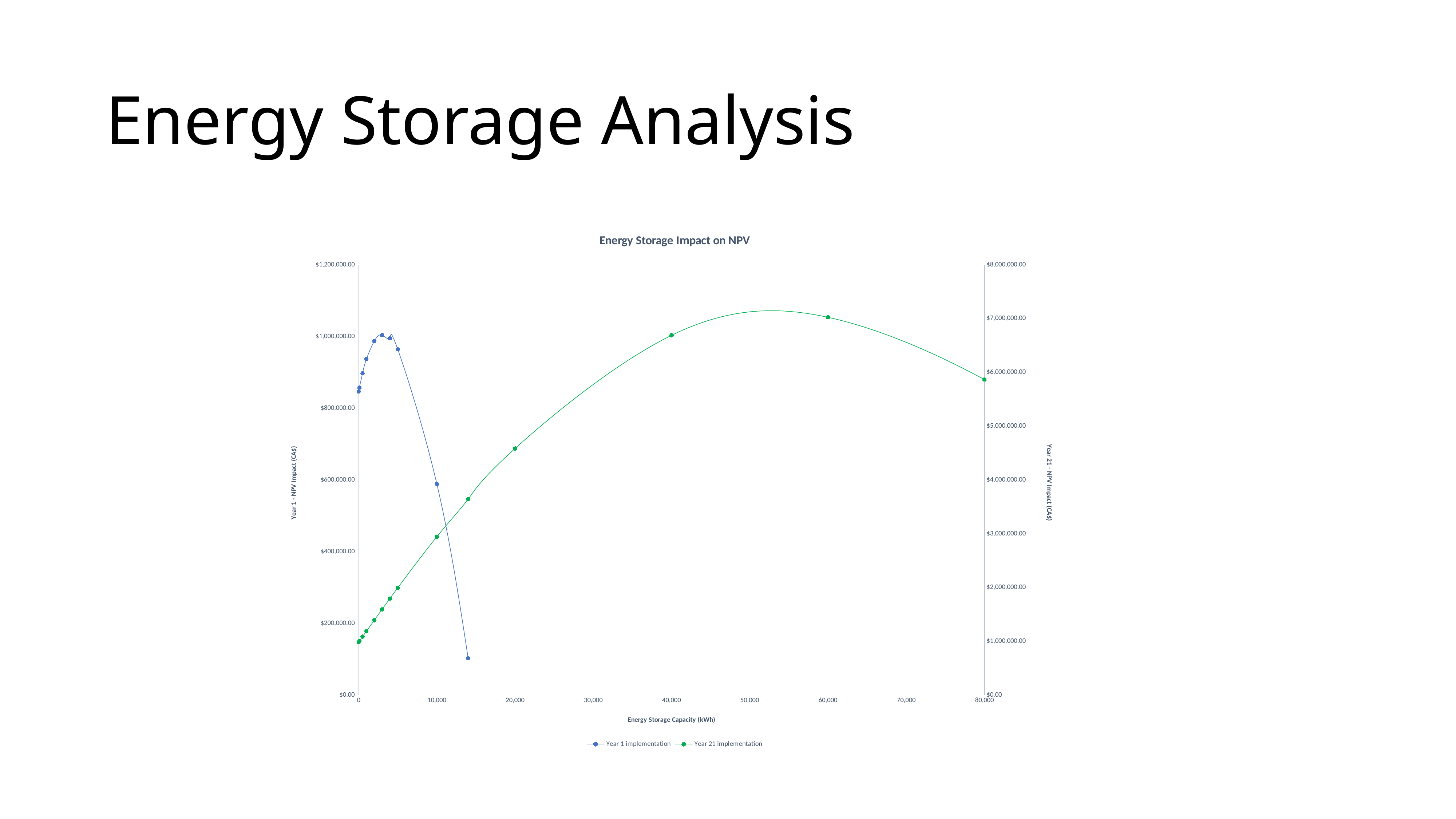
How many series does the legend list? 2 Does the Year 21 implementation series rise or fall between 0 and 40,000 kWh? rise Is the value for Year 21 implementation at 40,000 kWh greater or less than $6,000,000.00 on the right axis? greater What is the title of the chart? Energy Storage Impact on NPV Does the Year 1 implementation series rise or fall between 5,000 and 14,000 kWh? fall What is the label of the x axis? Energy Storage Capacity (kWh) What kind of chart is shown on the slide? Line chart Is the value for Year 21 implementation at 10,000 kWh greater or less than $2,000,000.00 on the right axis? greater Does the Year 21 implementation series rise or fall between 60,000 and 80,000 kWh? fall Is the value for Year 21 implementation at 20,000 kWh greater or less than $4,000,000.00 on the right axis? greater